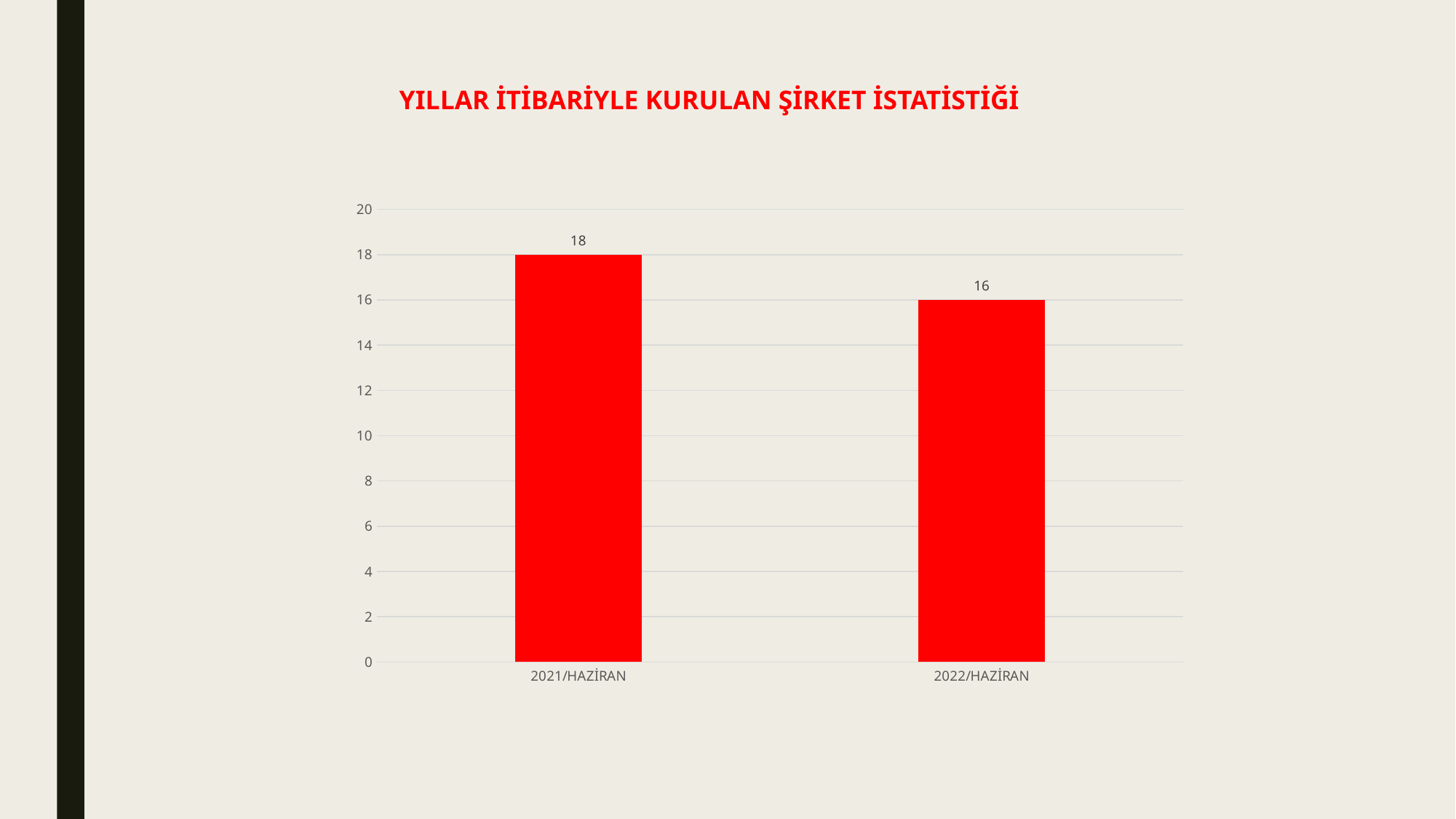
Is the value for 2022/HAZİRAN greater or less than 10? greater What is the difference between the values for 2021/HAZİRAN and 2022/HAZİRAN? 2 How many categories are shown on the x axis? 2 Do the values rise or fall from 2021/HAZİRAN to 2022/HAZİRAN? fall What colour are the bars in the chart? red What is the title of the chart? YILLAR İTİBARİYLE KURULAN ŞİRKET İSTATİSTİĞİ Which category has the highest value? 2021/HAZİRAN What is the value for 2021/HAZİRAN? 18 What is the value for 2022/HAZİRAN? 16 Which category has the lowest value? 2022/HAZİRAN Which is larger, the value for 2021/HAZİRAN or the value for 2022/HAZİRAN? 2021/HAZİRAN What kind of chart is shown on the slide? bar chart